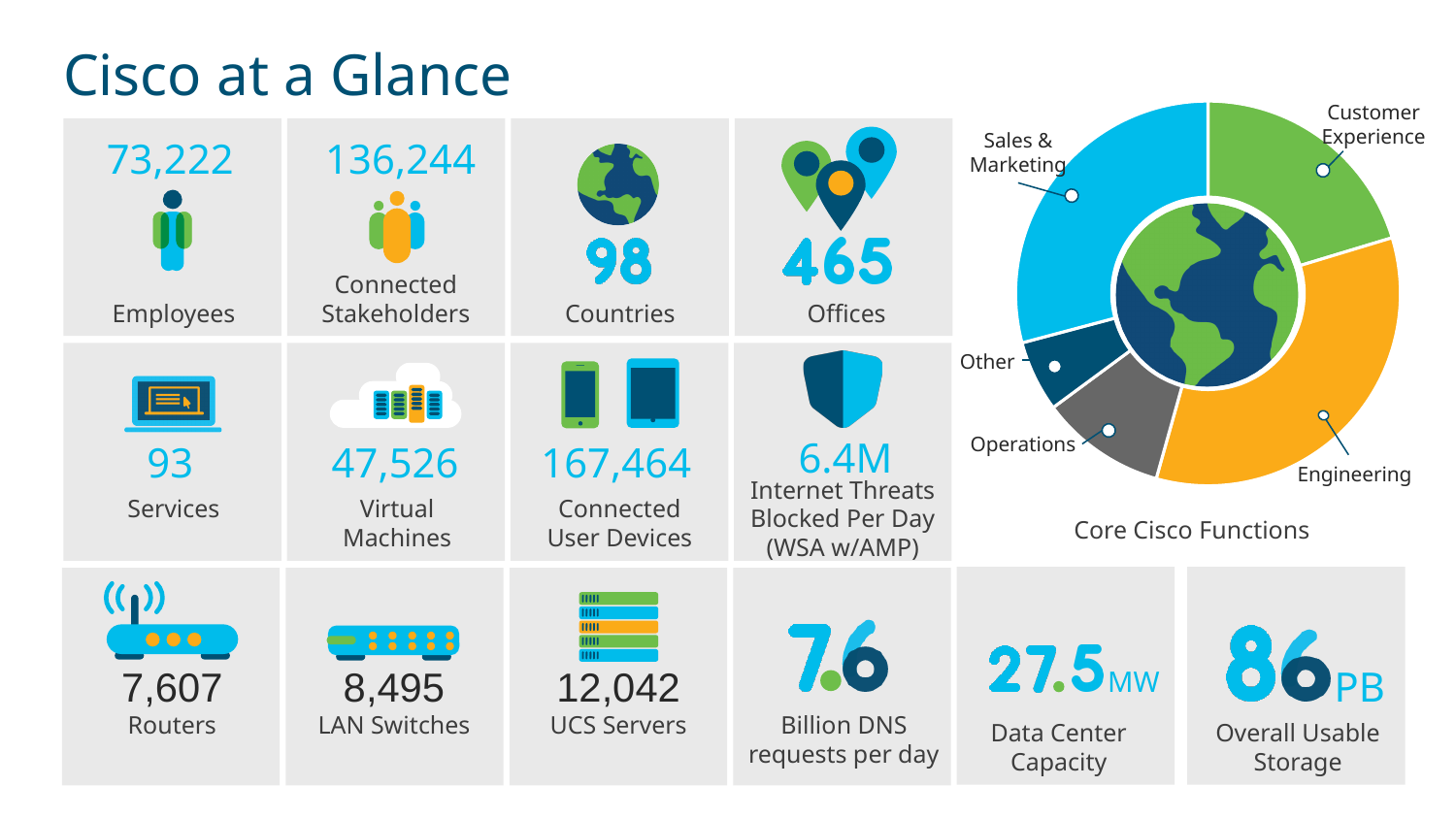
What colour is the Engineering slice in the Core Cisco Functions pie chart? orange What kind of chart is the Core Cisco Functions chart? doughnut chart In the Core Cisco Functions pie chart, which slice is larger: Sales & Marketing or Customer Experience? Sales & Marketing What is the title of the pie chart on the slide? Core Cisco Functions In the Core Cisco Functions pie chart, which slice is larger: Operations or Other? Operations Which function has the largest slice in the Core Cisco Functions pie chart? Engineering In the Core Cisco Functions pie chart, which slice is larger: Customer Experience or Operations? Customer Experience How many slices does the Core Cisco Functions pie chart have? 5 Which function has the smallest slice in the Core Cisco Functions pie chart? Other